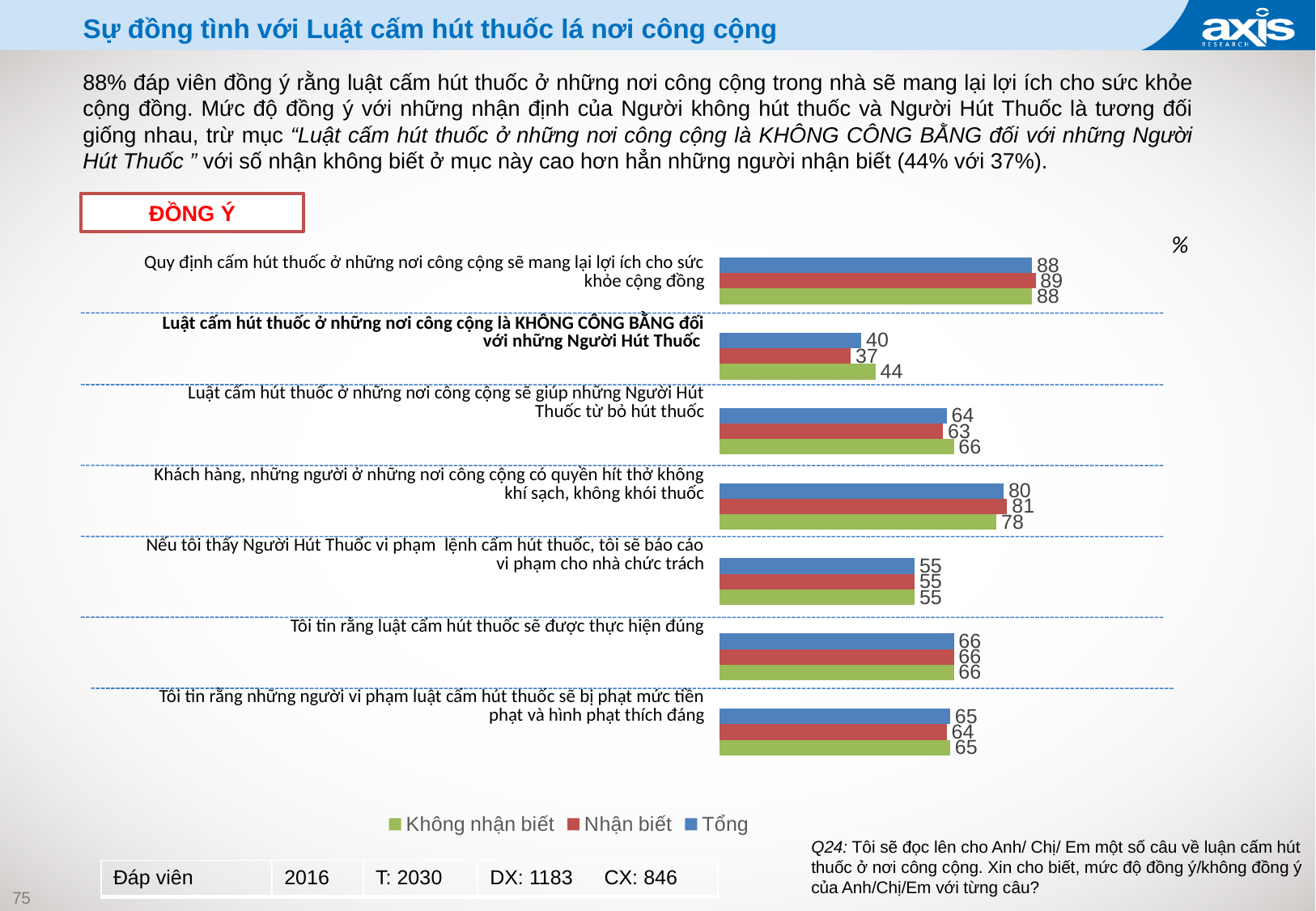
How many statement categories are plotted in the chart? 7 Which statement has the lowest Tổng value? Luật cấm hút thuốc ở những nơi công cộng là KHÔNG CÔNG BẰNG đối với những Người Hút Thuốc What is the difference between the Không nhận biết and Nhận biết values for "Luật cấm hút thuốc ở những nơi công cộng là KHÔNG CÔNG BẰNG đối với những Người Hút Thuốc"? 7 How many series does the legend list? 3 What kind of chart is shown on the slide? bar chart Which statement has the highest Nhận biết value? Quy định cấm hút thuốc ở những nơi công cộng sẽ mang lại lợi ích cho sức khỏe cộng đồng What is the Tổng value for "Quy định cấm hút thuốc ở những nơi công cộng sẽ mang lại lợi ích cho sức khỏe cộng đồng"? 88 What is the Tổng value for "Nếu tôi thấy Người Hút Thuốc vi phạm lệnh cấm hút thuốc, tôi sẽ báo cáo vi phạm cho nhà chức trách"? 55 Which colour represents the Tổng series in the chart? blue What is the Không nhận biết value for "Luật cấm hút thuốc ở những nơi công cộng là KHÔNG CÔNG BẰNG đối với những Người Hút Thuốc"? 44 What is the Nhận biết value for "Khách hàng, những người ở những nơi công cộng có quyền hít thở không khí sạch, không khói thuốc"? 81 For "Khách hàng, những người ở những nơi công cộng có quyền hít thở không khí sạch, không khói thuốc", which is larger: the Nhận biết value or the Không nhận biết value? Nhận biết